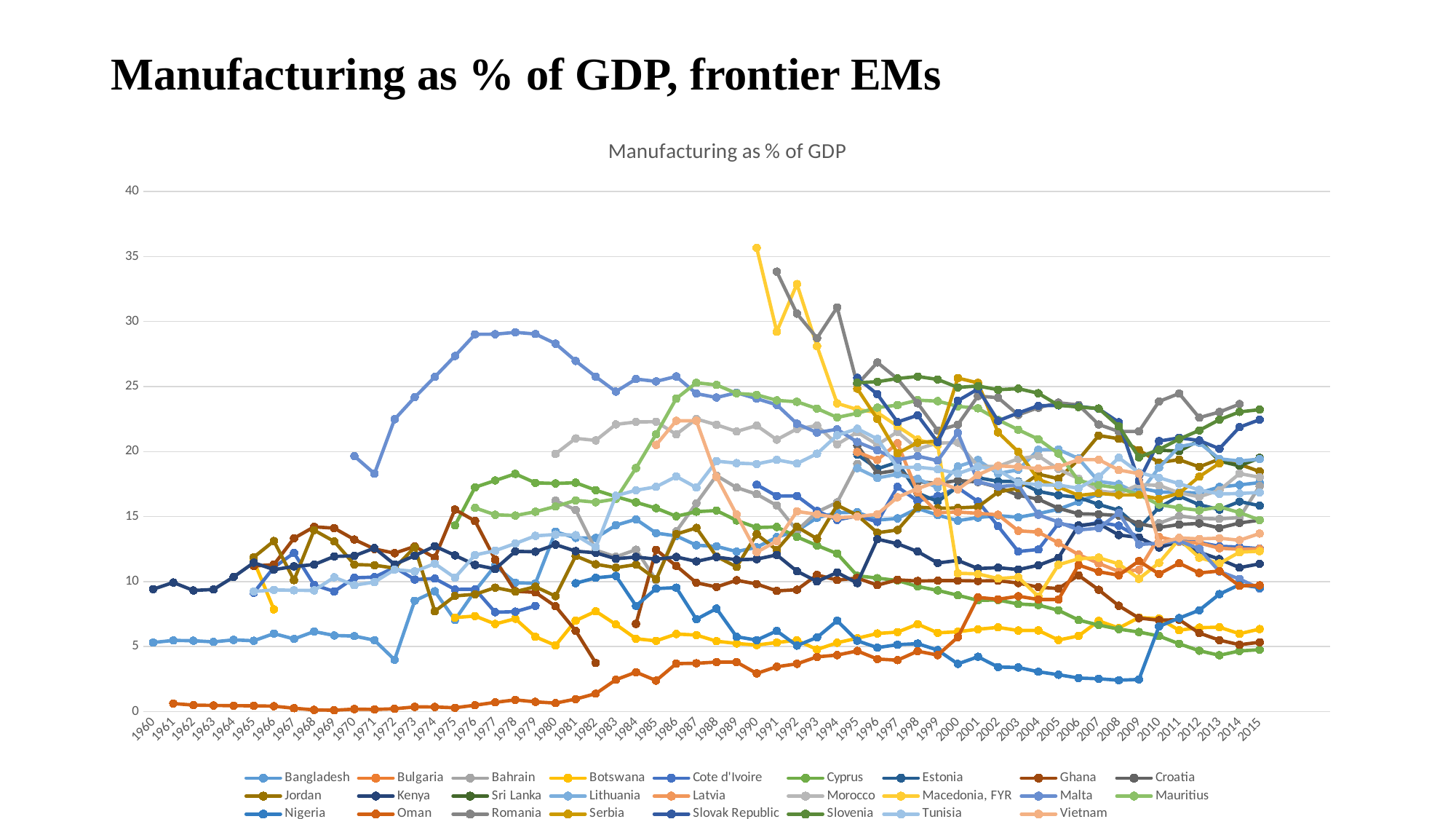
Is the value for Oman in 1961 greater or less than 5? less What is the last year shown on the x axis of the chart? 2015 How many series does the chart's legend list? 26 Does the line for Oman rise or fall overall from 1960 to 2015? rise In which year does the single highest point on the chart occur? 1990 What is the first year shown on the x axis of the chart? 1960 Is the value for Romania in 1991 greater or less than 30? greater How many years are plotted along the x axis of the chart? 56 What kind of chart is shown on the slide? line chart What is the title printed above the plot area of the chart? Manufacturing as % of GDP What is the highest value shown on the y axis of the chart? 40 Is the value for Macedonia, FYR in 1990 greater or less than 30? greater